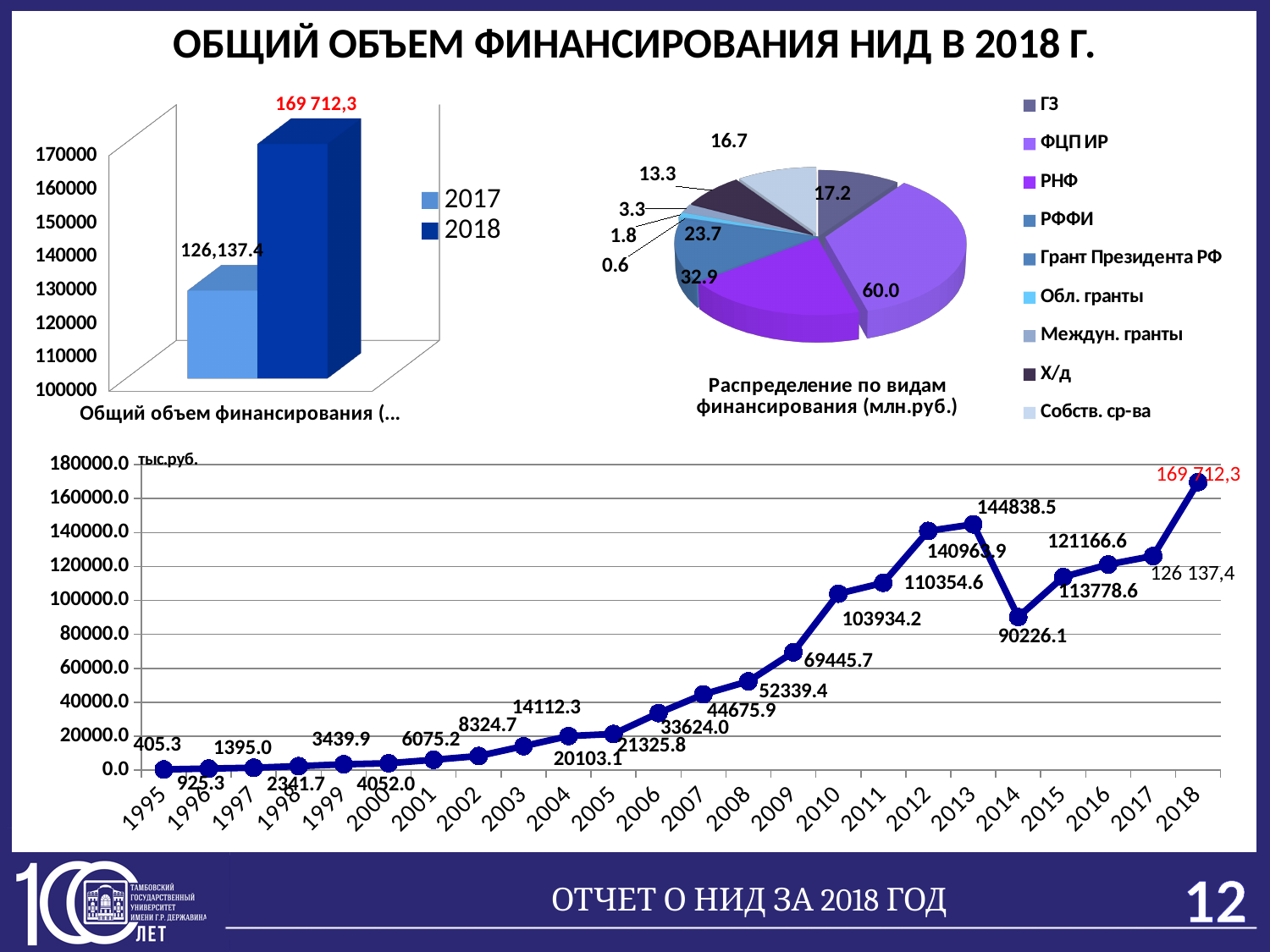
In the bar chart at the top left, what is the value for 2018? 169 712,3 In the pie chart 'Распределение по видам финансирования (млн.руб.)', what is the smallest value shown? 0.6 In the pie chart 'Распределение по видам финансирования (млн.руб.)', what is the largest value shown? 60.0 In the line chart at the bottom, what is the difference between the values for 2013 and 2014? 54612.4 In the line chart at the bottom, what is the value for 2009? 69445.7 In the line chart at the bottom, what is the value for 2014? 90226.1 In the bar chart at the top left, what is the value for 2017? 126,137.4 In the line chart at the bottom, which year has the highest value? 2018 In the line chart at the bottom, how many years are plotted on the x axis? 24 What kind of chart is the chart at the top left of the slide? bar chart How many series does the legend of the bar chart at the top left list? 2 How many entries does the legend of the pie chart 'Распределение по видам финансирования (млн.руб.)' list? 9